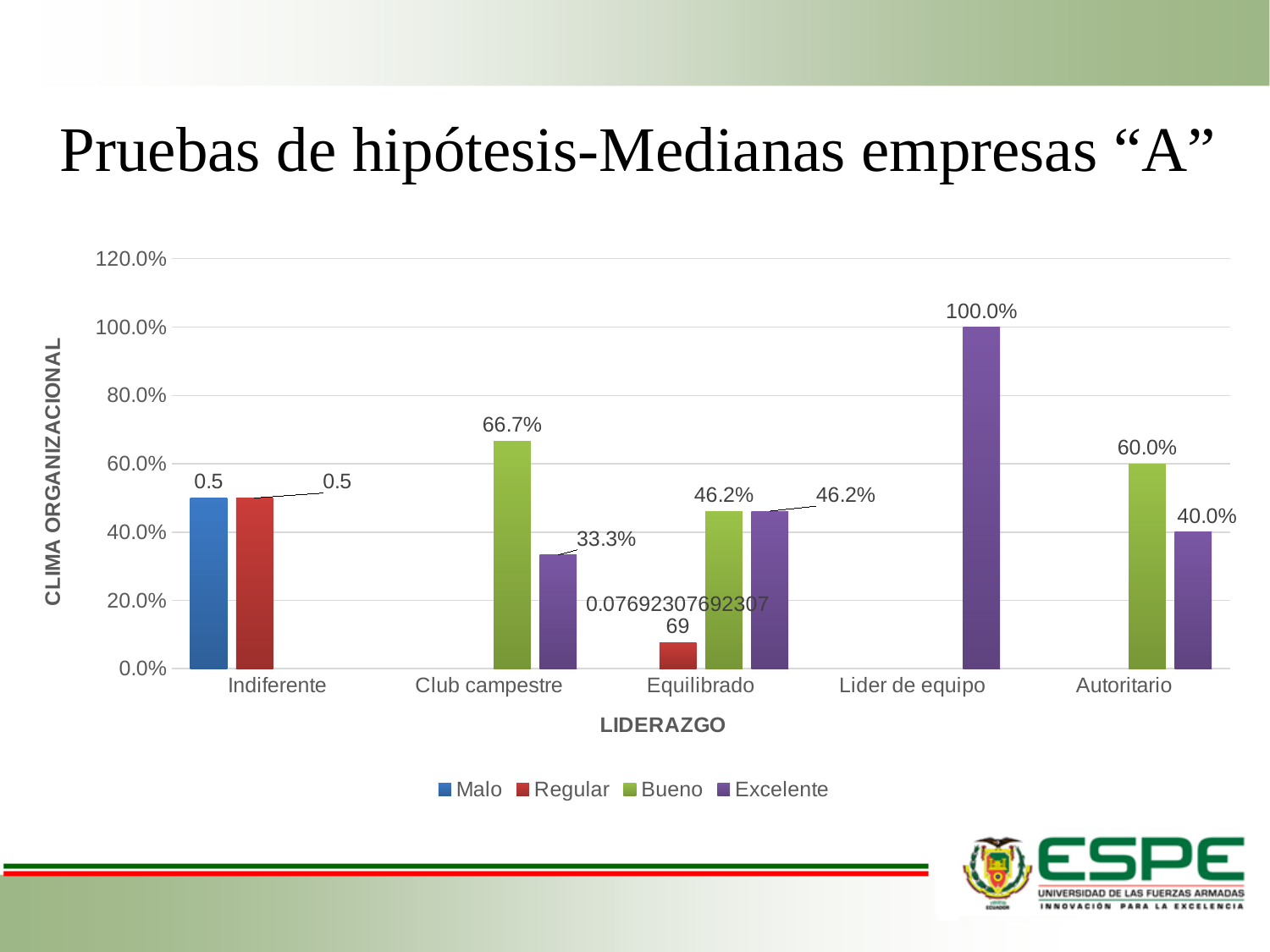
What is the difference between the Bueno and Excelente values in the Autoritario category? 20.0% What type of chart is shown on the slide? bar chart What is the value for Excelente in the Lider de equipo category? 100.0% How many series does the legend list? 4 How many leadership categories are shown on the x axis? 5 Which category has the highest bar in the chart? Lider de equipo What is the title of the x axis? LIDERAZGO What is the difference between the Bueno and Excelente values in the Club campestre category? 33.4% What is the value for Excelente in the Autoritario category? 40.0% What is the value for Bueno in the Equilibrado category? 46.2% What is the value for Bueno in the Club campestre category? 66.7% Which is larger in the Club campestre category, Bueno or Excelente? Bueno